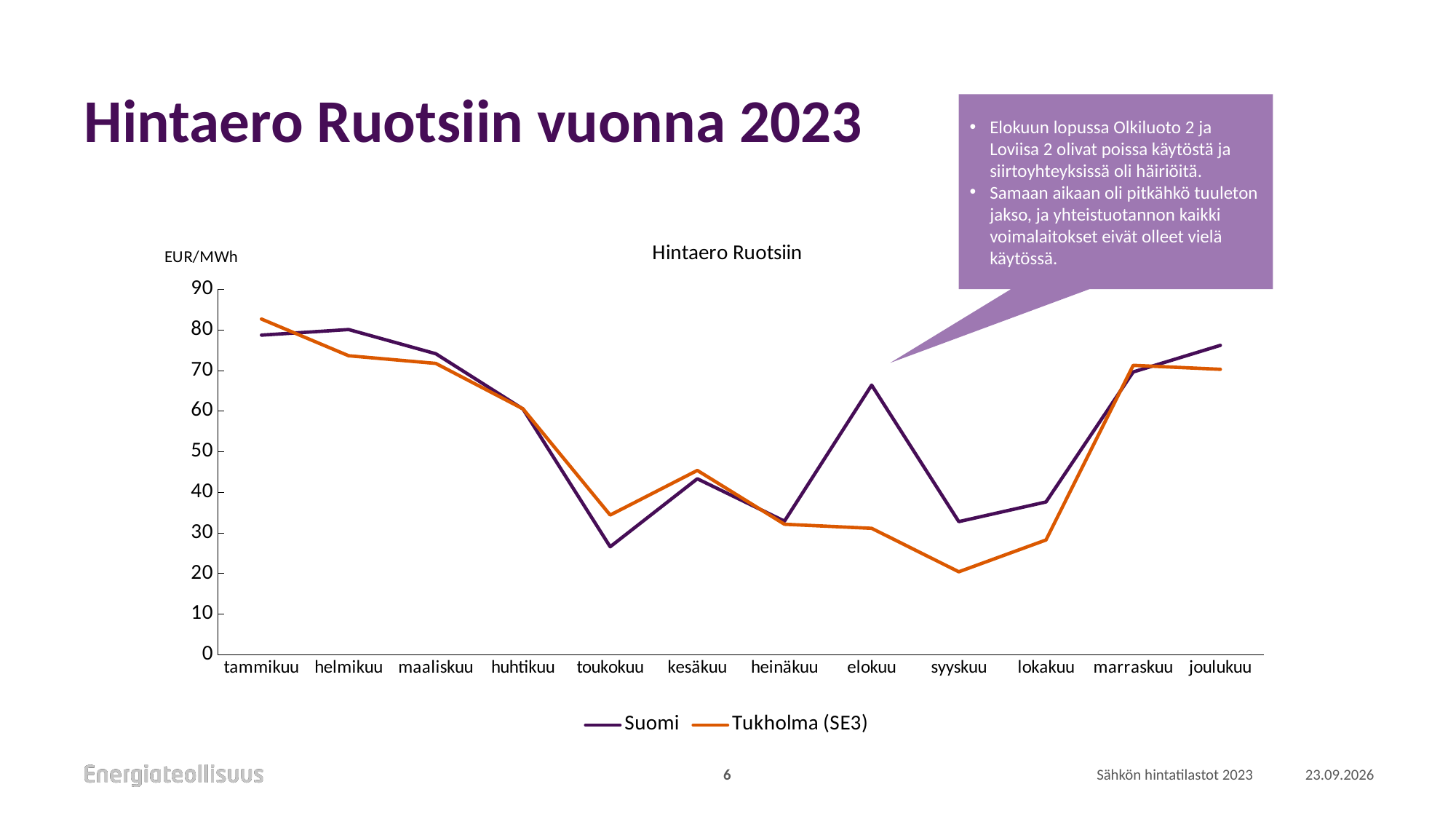
How many months are shown on the x axis? 12 What unit is shown on the y axis of the chart? EUR/MWh In toukokuu, which series has the larger value, Suomi or Tukholma (SE3)? Tukholma (SE3) Is the Tukholma (SE3) value for syyskuu greater or less than 30? less Is the Suomi value for elokuu greater or less than 60? greater In which month is the Tukholma (SE3) value lowest? syyskuu In elokuu, which series has the larger value, Suomi or Tukholma (SE3)? Suomi In which month is the Tukholma (SE3) value highest? tammikuu In which month is the Suomi value lowest? toukokuu What kind of chart is shown on the slide? line chart Do the Suomi values rise or fall from tammikuu to toukokuu? fall How many series does the legend list? 2